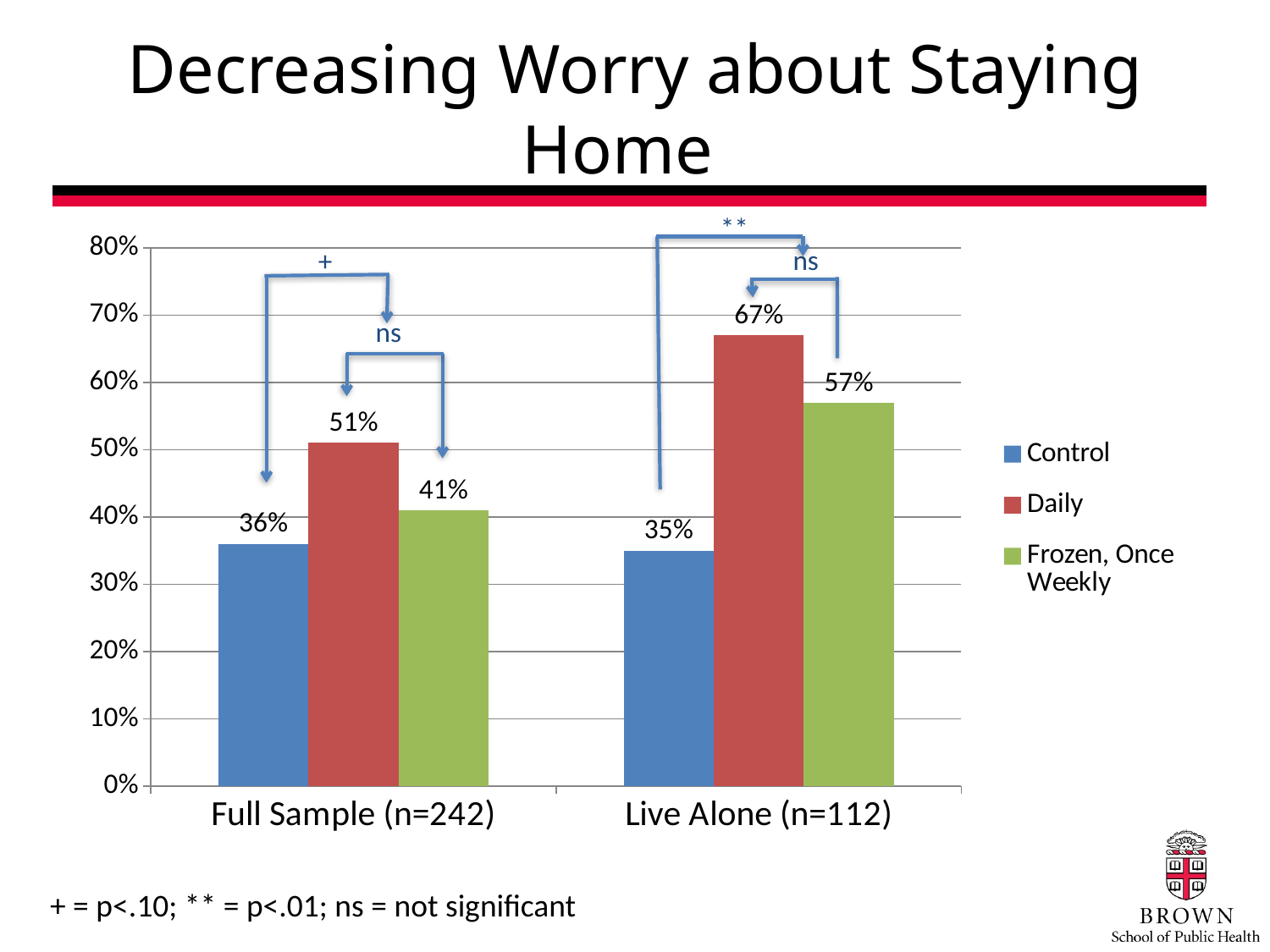
How many series does the legend list? 3 Which series has the highest value in the Live Alone (n=112) group? Daily What is the value for Frozen, Once Weekly in the Live Alone (n=112) group? 57% What is the difference between the Daily and Control values in the Live Alone (n=112) group? 32% What is the value for Control in the Live Alone (n=112) group? 35% How many categories are shown on the x axis? 2 What is the difference between the Daily and Frozen, Once Weekly values in the Full Sample (n=242) group? 10% Is the value for Daily in the Live Alone (n=112) group greater or less than 60%? greater What kind of chart is shown on the slide? Bar chart Which is larger: the Frozen, Once Weekly value for Full Sample (n=242) or for Live Alone (n=112)? Live Alone (n=112) What is the value for Daily in the Full Sample (n=242) group? 51% Which series has the lowest value in the Full Sample (n=242) group? Control